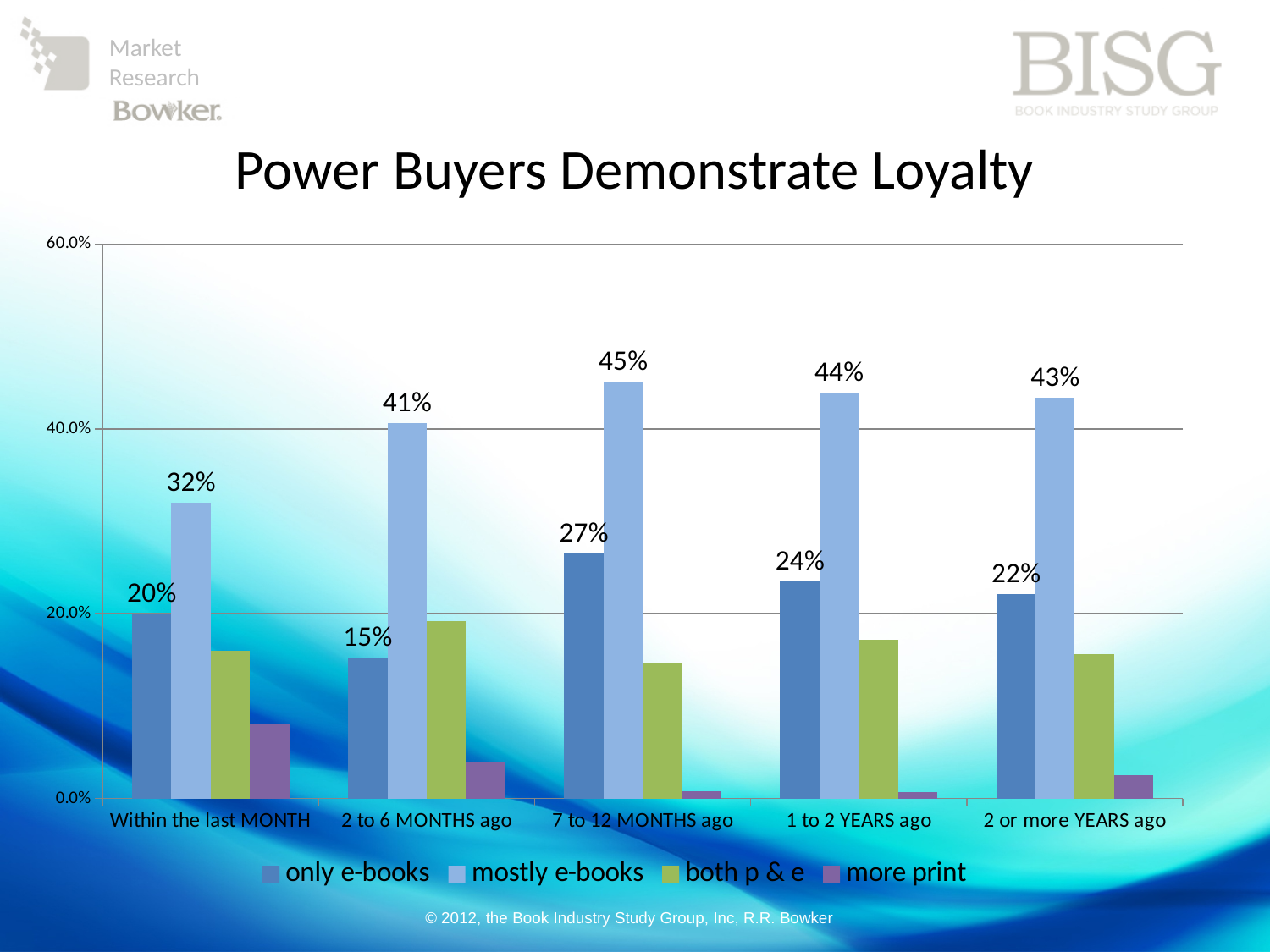
What is the title of the chart? Power Buyers Demonstrate Loyalty What kind of chart is shown on the slide? bar chart Which is larger in the "2 or more YEARS ago" category: "only e-books" or "mostly e-books"? mostly e-books What is the difference between the "mostly e-books" and "only e-books" values in the "1 to 2 YEARS ago" category? 20% Which category has the lowest value for "only e-books"? 2 to 6 MONTHS ago Which category has the highest value for "mostly e-books"? 7 to 12 MONTHS ago How many categories are shown on the x axis? 5 What is the value for "mostly e-books" in the "Within the last MONTH" category? 32% What is the value for "mostly e-books" in the "7 to 12 MONTHS ago" category? 45% How many series does the legend list? 4 What is the value for "only e-books" in the "2 to 6 MONTHS ago" category? 15%